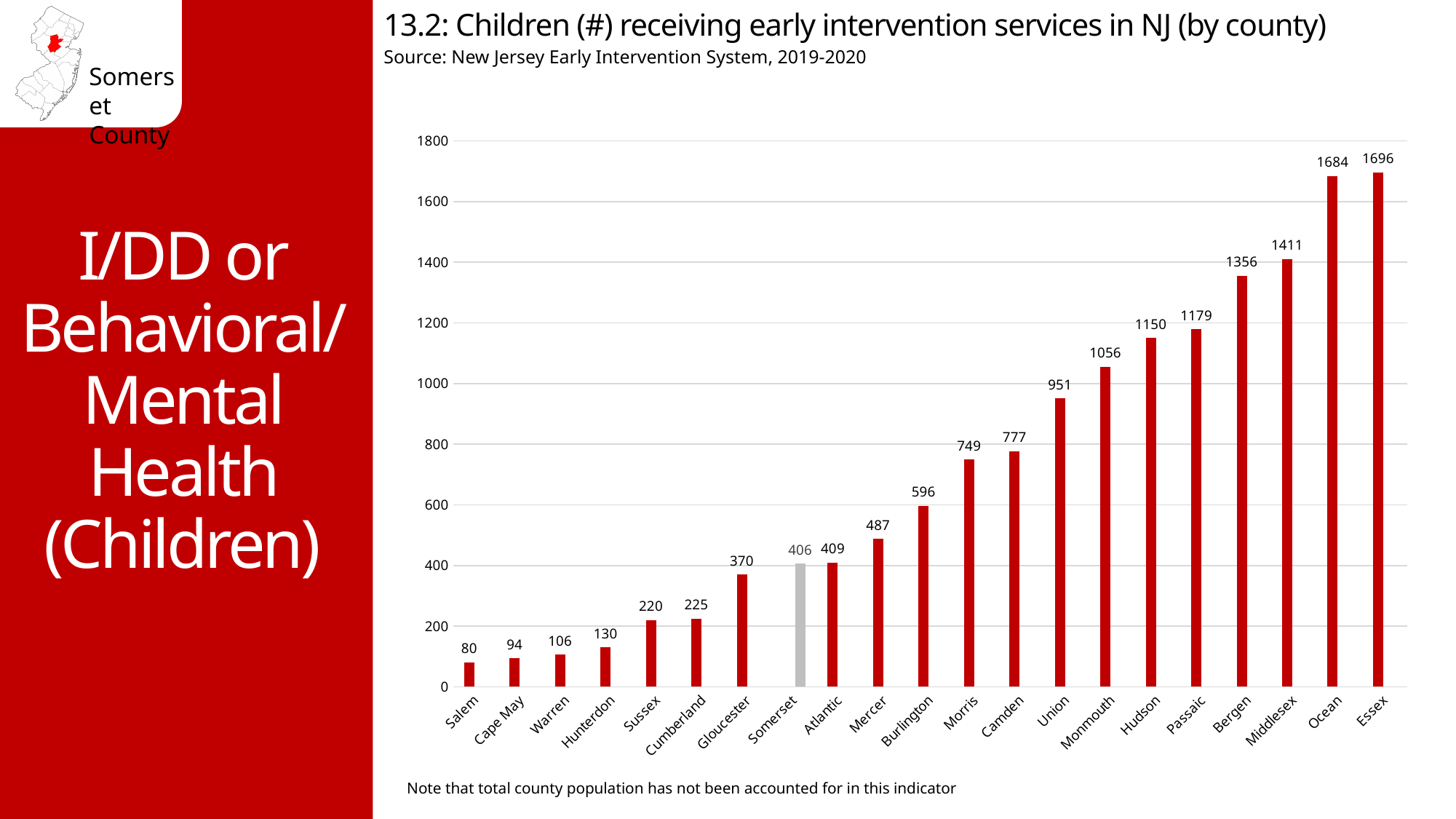
What is the value shown for Gloucester County? 370 What is the difference between the values for Essex and Ocean? 12 Which county's bar is shown in gray instead of red? Somerset Which county has the lowest number of children receiving early intervention services? Salem What type of chart is shown on the slide? Bar chart What is the value shown for Hudson County? 1150 Is the value for Union County greater or less than 1000? less Which county has a larger value, Bergen or Passaic? Bergen Which county has the highest number of children receiving early intervention services? Essex How many counties are shown on the chart? 21 What is the difference between the values for Somerset and Salem? 326 How many children received early intervention services in Somerset County? 406